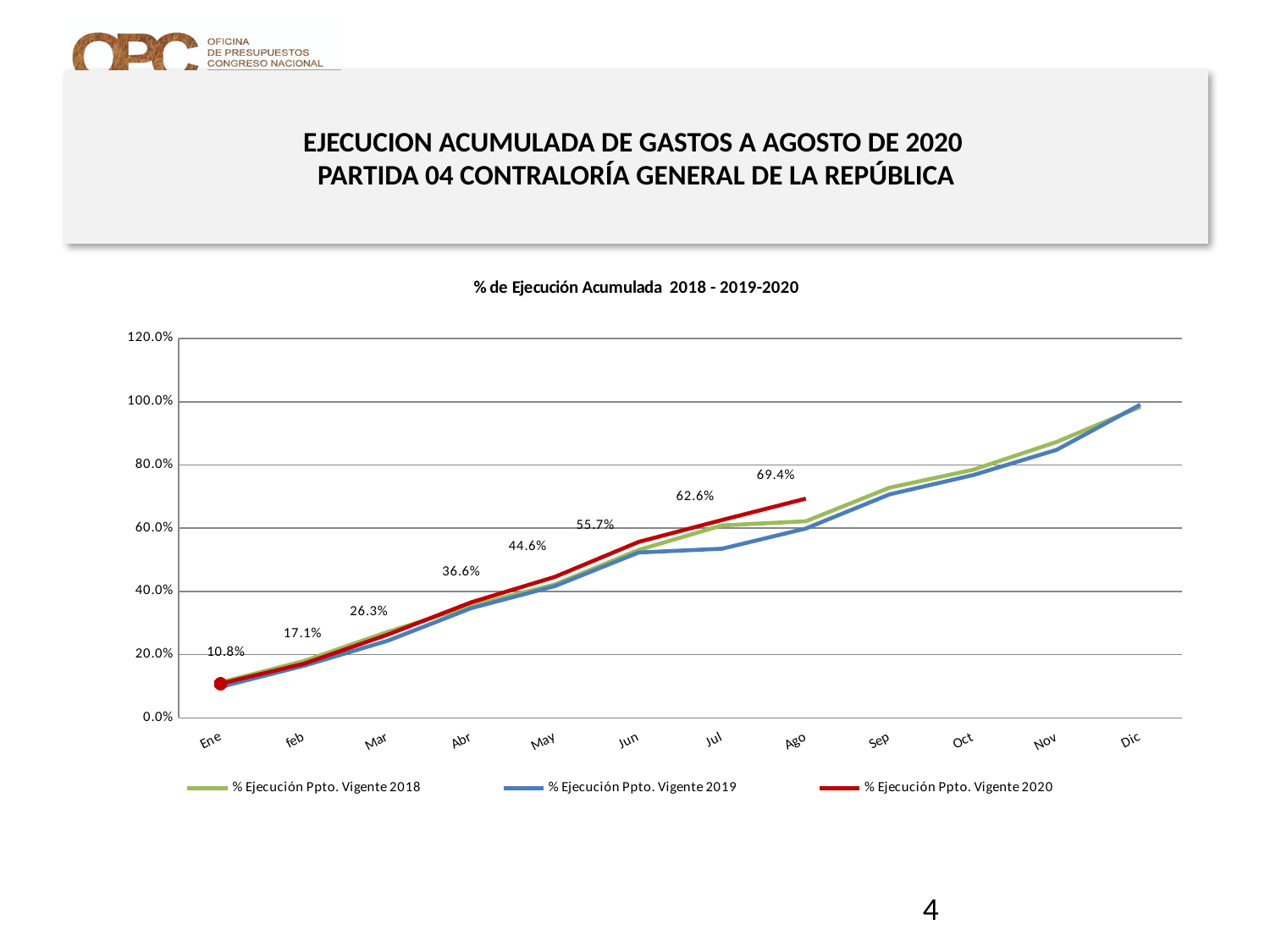
How many months are shown on the x axis? 12 What type of chart is shown on the slide? line chart What is the value of % Ejecución Ppto. Vigente 2020 in Abr? 36.6% What is the value of % Ejecución Ppto. Vigente 2020 in Ene? 10.8% Does the % Ejecución Ppto. Vigente 2020 line rise or fall from Ene to Ago? rise What is the difference between the % Ejecución Ppto. Vigente 2020 values for Ago and Jul? 6.8% Is the value for % Ejecución Ppto. Vigente 2019 in Jul greater or less than 60.0%? less What is the value of % Ejecución Ppto. Vigente 2020 in Jun? 55.7% How many series does the legend list? 3 What is the difference between the % Ejecución Ppto. Vigente 2020 values for Mar and Feb? 9.2% What is the value of % Ejecución Ppto. Vigente 2020 in Ago? 69.4% What is the title of the chart? % de Ejecución Acumulada 2018 - 2019-2020